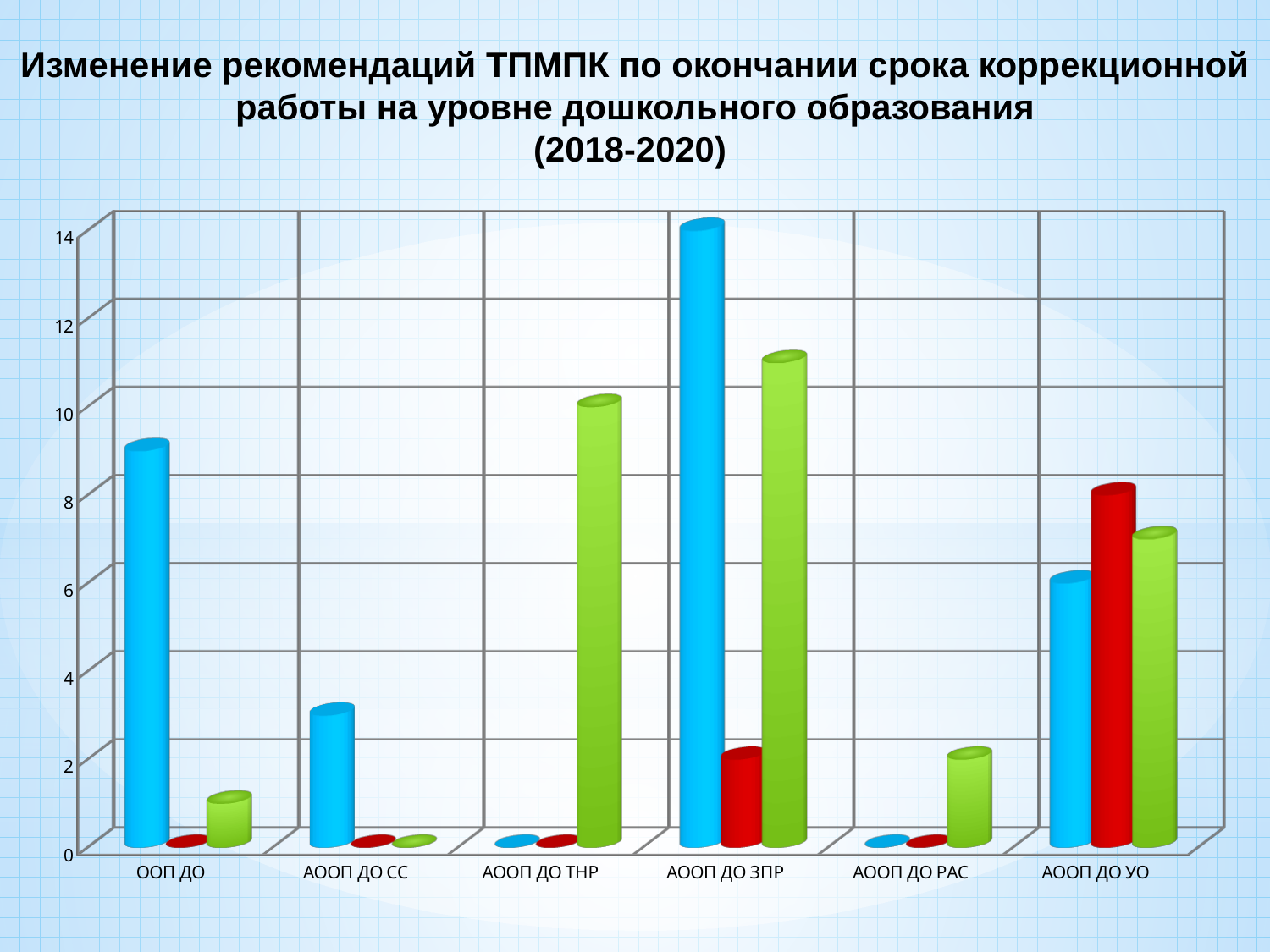
Which is larger: the green bar for АООП ДО ЗПР or the green bar for АООП ДО РАС? АООП ДО ЗПР How many categories are shown on the x axis of the chart? 6 Is the value of the green bar for АООП ДО ТНР greater or less than 8? greater What is the highest value shown on the vertical axis of the chart? 14 What kind of chart is shown on the slide? bar chart Is the value of the blue bar for АООП ДО СС greater or less than 4? less Is the value of the green bar for АООП ДО РАС greater or less than 4? less Which category has the tallest bar in the chart? АООП ДО ЗПР What is the value of the tallest (blue) bar for АООП ДО ЗПР? 14 Which is larger: the blue bar for ООП ДО or the blue bar for АООП ДО СС? ООП ДО